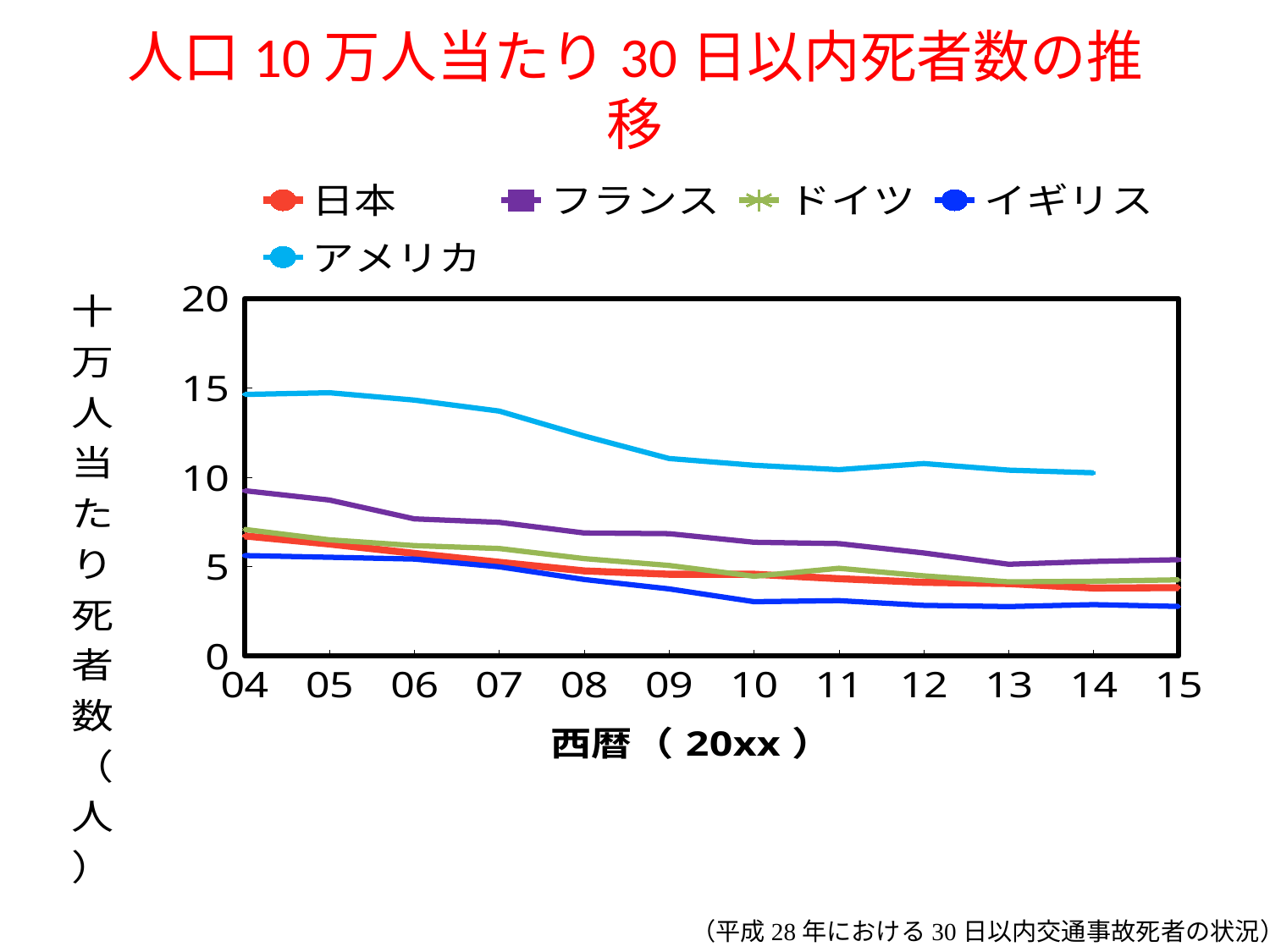
Which country has the lowest value in 04? イギリス In 04, which is larger, the value for フランス or the value for 日本? フランス How many series does the legend list? 5 Is the value for イギリス in 15 greater or less than 5? less Is the value for アメリカ in 04 greater or less than 10? greater Does the value for アメリカ rise or fall from 04 to 14? fall Is the value for フランス in 04 greater or less than 5? greater Which country has the lowest value in 15? イギリス How many years are marked along the x axis? 12 What is the title of the chart? 人口10万人当たり30日以内死者数の推移 What kind of chart is shown on the slide? line chart Which country has the highest value in 04? アメリカ